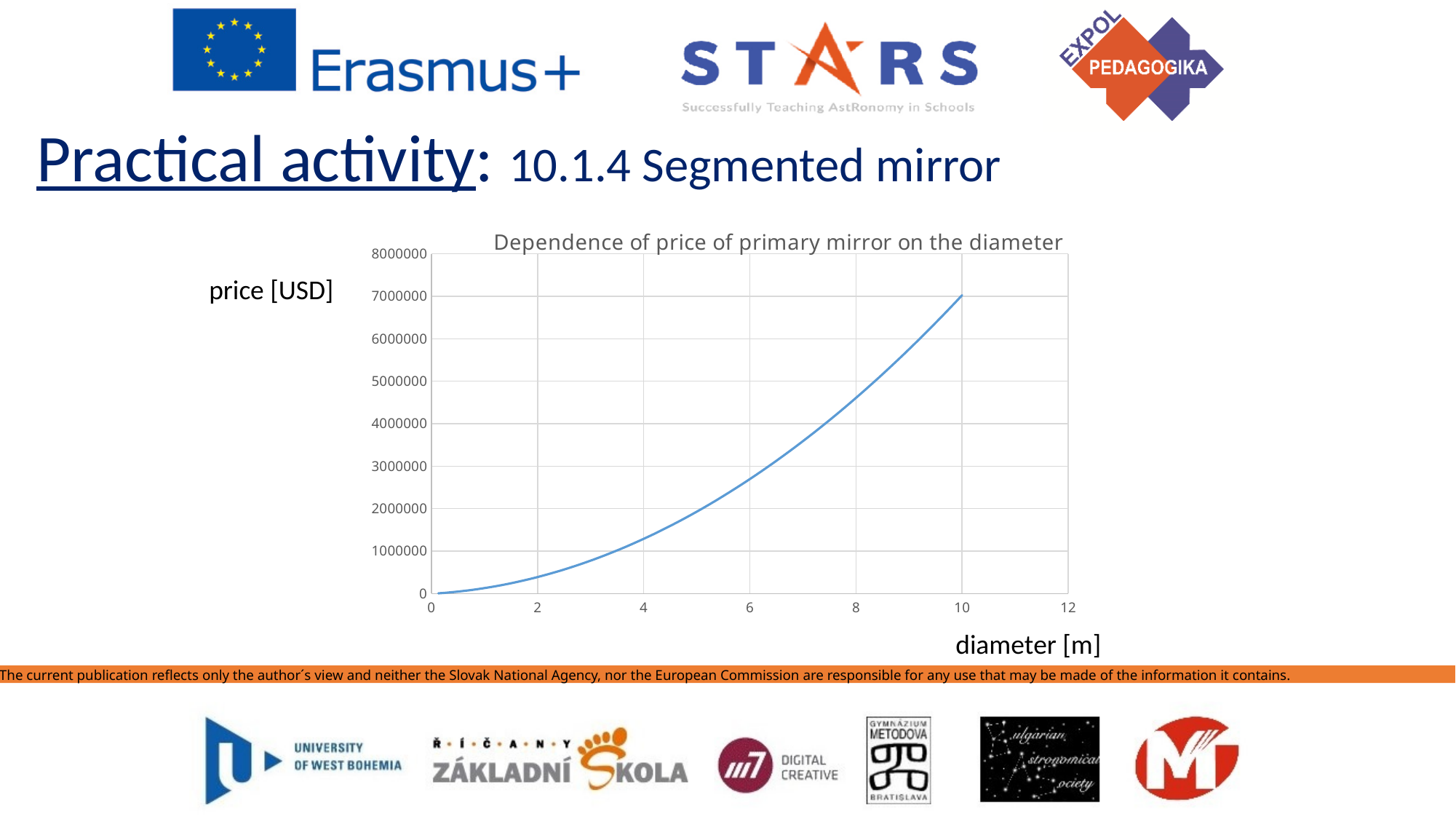
Which is larger, the price at a diameter of 4 m or the price at a diameter of 8 m? 8 m How many data series are plotted in the chart? 1 Does the price rise or fall as the diameter increases along the x axis? rise Is the price at a diameter of 4 m greater or less than 1000000? greater Is the price at a diameter of 2 m greater or less than 1000000? less Is the price at a diameter of 8 m greater or less than 4000000? greater What kind of chart is shown on the slide? line chart What is the title of the chart? Dependence of price of primary mirror on the diameter What quantity is plotted on the vertical axis of the chart? price [USD] At which diameter shown on the x axis does the plotted price reach its highest value? 10